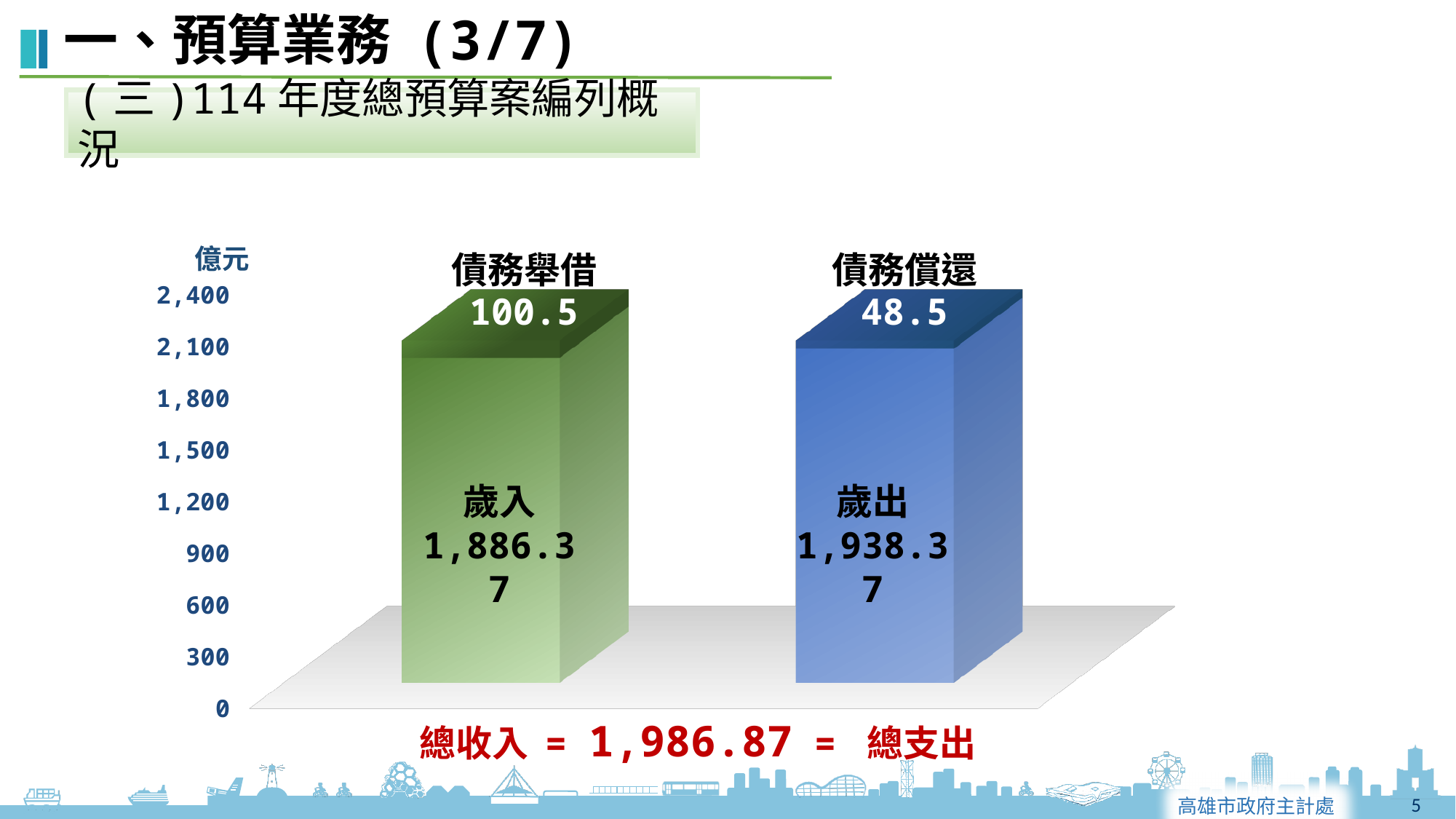
What unit is shown on the vertical axis of the chart? 億元 What is the value of 歲入 shown on the green bar? 1,886.37 What is the value of 債務償還 shown on the chart? 48.5 What is the total of the blue bar (歲出 plus 債務償還)? 1,986.87 Which is larger, 債務舉借 or 債務償還? 債務舉借 What is the total of the green bar (歲入 plus 債務舉借)? 1,986.87 Which is larger, 歲入 or 歲出? 歲出 What is the value of 債務舉借 shown on the chart? 100.5 What is the difference between 債務舉借 and 債務償還? 52 What is the difference between 歲出 and 歲入? 52 What kind of chart is shown on the slide? Bar chart What is the value of 歲出 shown on the blue bar? 1,938.37